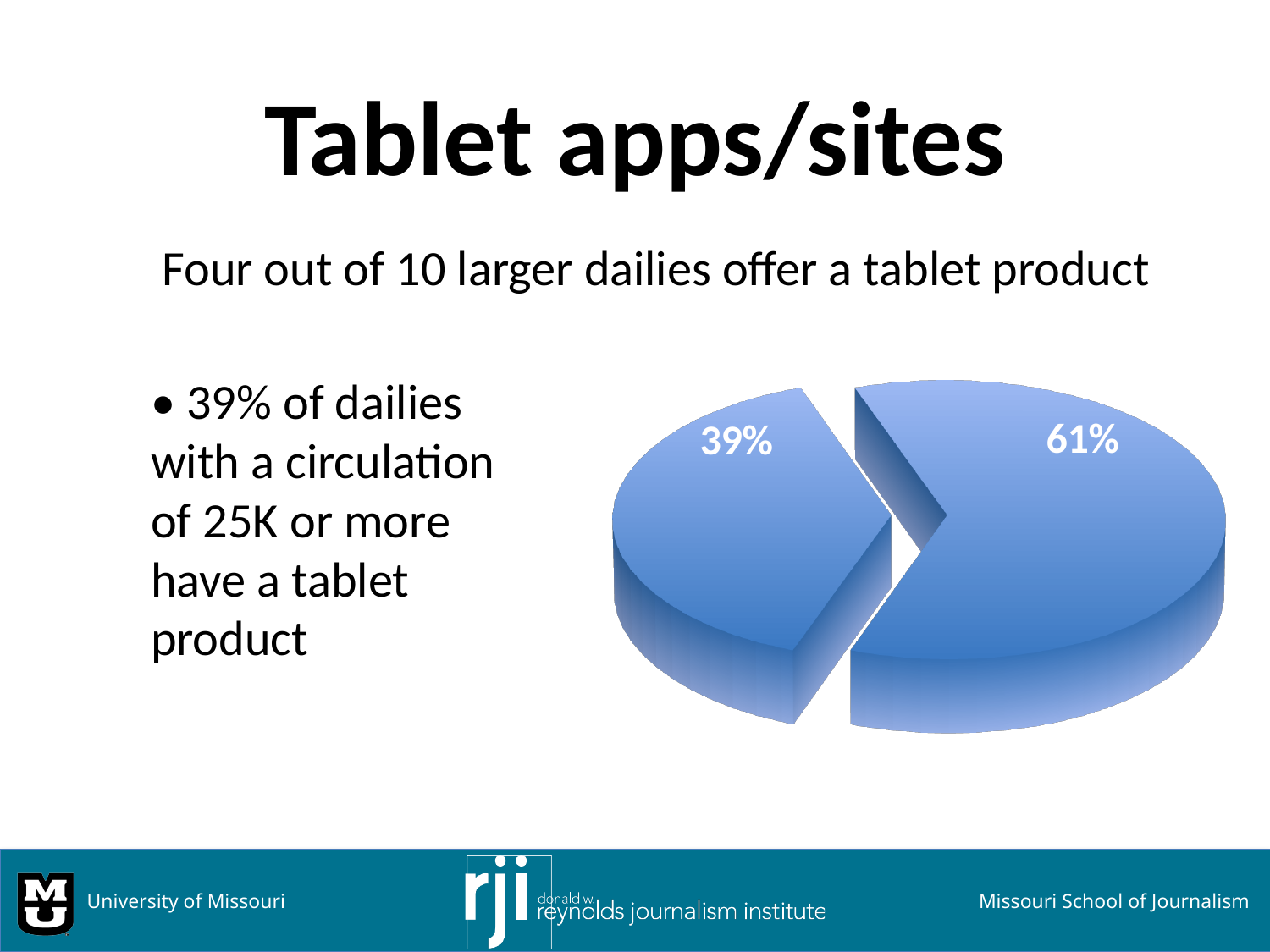
What is the title of the slide containing the pie chart? Tablet apps/sites Is the pie chart drawn in 3D with an exploded slice? yes What share of the pie does the slice on the left-hand side represent? 39% What share of the pie does the slice on the right-hand side represent? 61% Which slice is larger, the one labelled 39% or the one labelled 61%? 61% How many slices does the pie chart have? 2 What do the two slices of the pie chart add up to? 100% What is the value of the larger slice of the pie chart? 61% What is the difference between the two slices of the pie chart? 22% Is the value of the smaller slice greater or less than 50%? less What is the value of the smaller slice of the pie chart? 39% What kind of chart is shown on the slide? pie chart